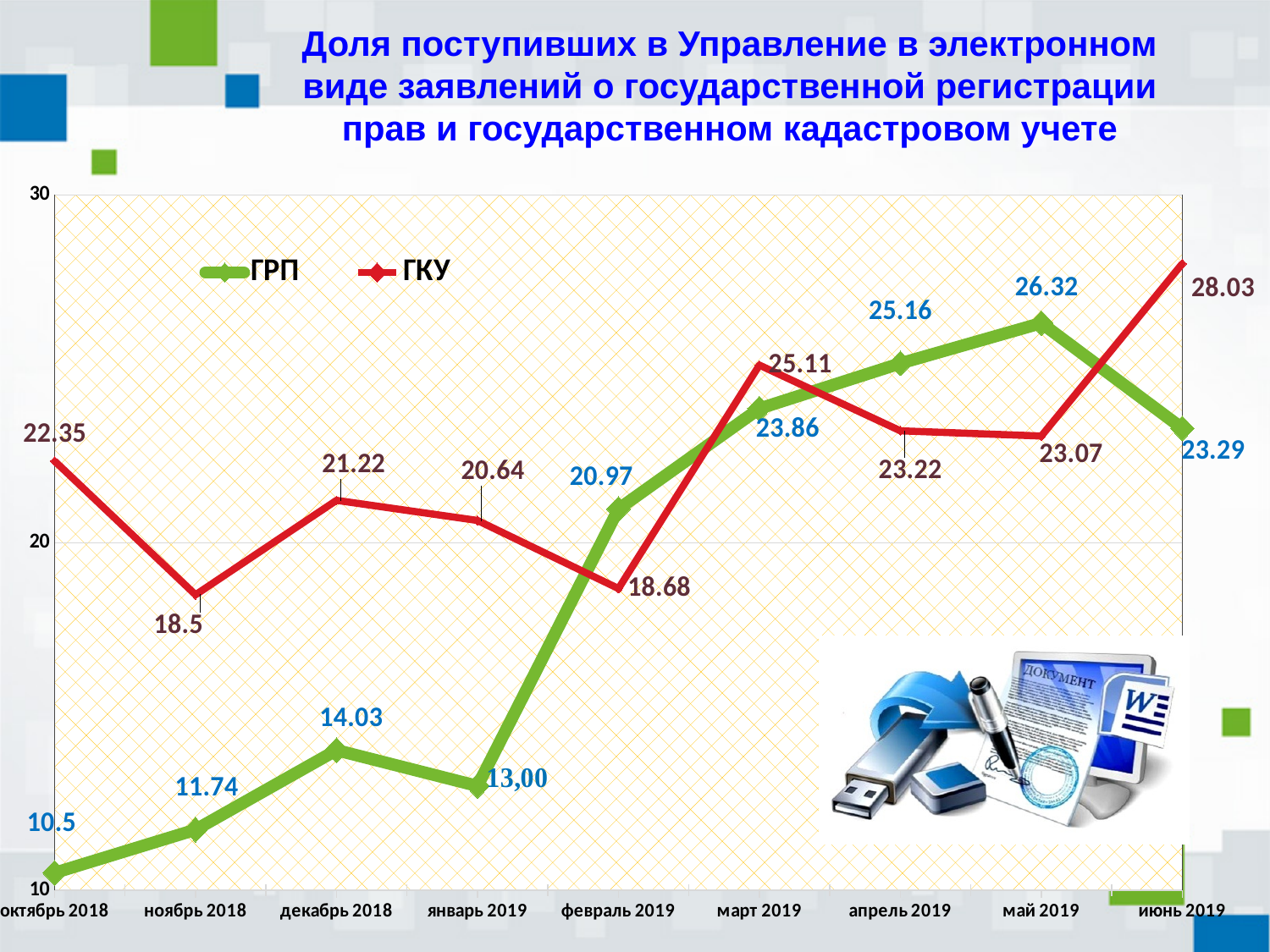
What type of chart is shown on the slide? line chart What is the value of ГКУ for ноябрь 2018? 18.5 Which series has the higher value in май 2019, ГРП or ГКУ? ГРП Is the ГРП value for январь 2019 greater or less than 20? less How many months are shown on the x axis? 9 In which month does the ГРП series reach its highest value? май 2019 In which month is the ГКУ series at its lowest value? ноябрь 2018 Does the ГРП series rise or fall from октябрь 2018 to май 2019 overall? rise What is the value of ГРП for март 2019? 23.86 What is the difference between the ГКУ and ГРП values for октябрь 2018? 11.85 How many series does the legend list? 2 What is the value of ГКУ for июнь 2019? 28.03